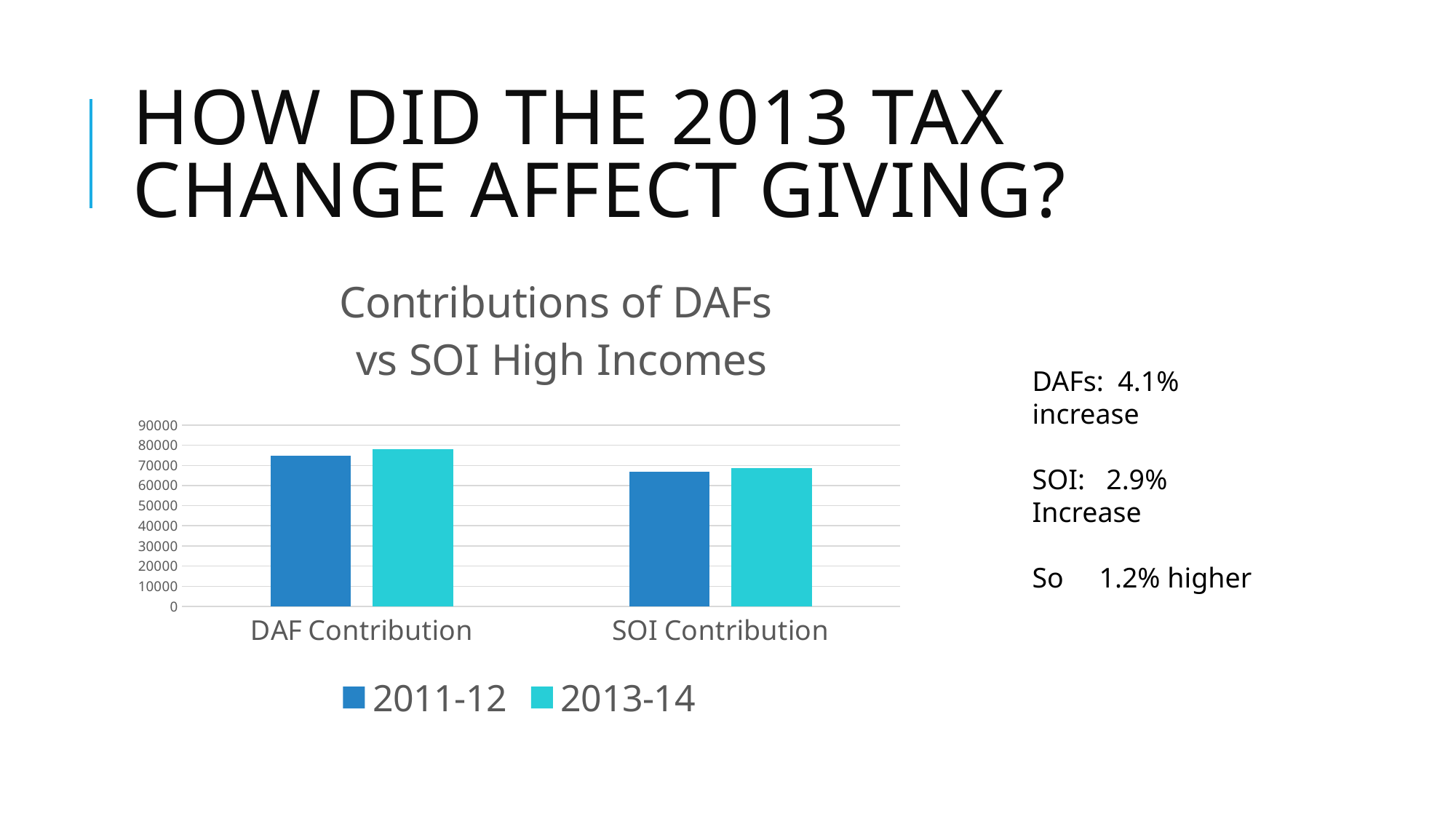
What is the title of the chart? Contributions of DAFs vs SOI High Incomes Is the 2013-14 value for SOI Contribution greater or less than 80000? less Is the 2011-12 value for SOI Contribution greater or less than 60000? greater How many series does the chart legend list? 2 Which series is shown in the darker blue colour in the chart? 2011-12 What kind of chart is shown on the slide? bar chart Is the 2013-14 value for DAF Contribution greater or less than 80000? less Which bar in the chart is the shortest overall? SOI Contribution, 2011-12 Which bar in the chart is the tallest overall? DAF Contribution, 2013-14 For the 2011-12 series, which category has the larger value, DAF Contribution or SOI Contribution? DAF Contribution How many categories are shown on the x axis of the chart? 2